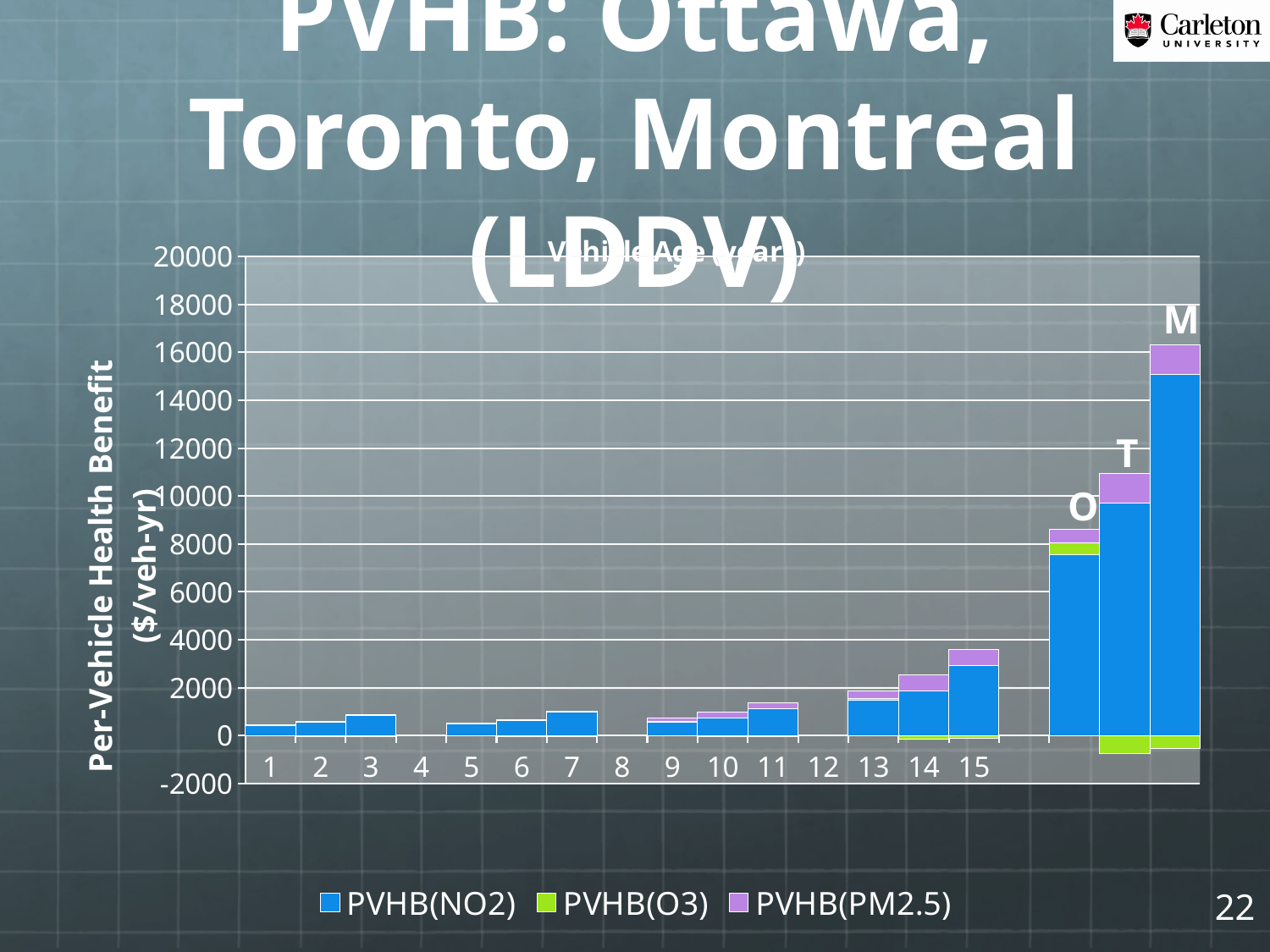
What kind of chart is shown on the slide? Stacked bar chart Is the PVHB(NO2) value for vehicle age 15 greater or less than 2000? greater How many series does the legend list? 3 Is the PVHB(NO2) value for the bar labelled O greater or less than 8000? less Is the PVHB(NO2) value for vehicle age 3 greater or less than 2000? less What is the label of the vertical axis? Per-Vehicle Health Benefit ($/veh-yr) Which series are listed in the legend? PVHB(NO2), PVHB(O3), PVHB(PM2.5) Among the bars labelled O, T and M, which has the highest PVHB(NO2) value? M Which has the larger PVHB(NO2) value, the bar labelled T or the bar labelled O? T How many numbered vehicle-age categories are shown on the x axis? 15 Do the PVHB(NO2) values rise or fall from vehicle age 13 to vehicle age 15? rise